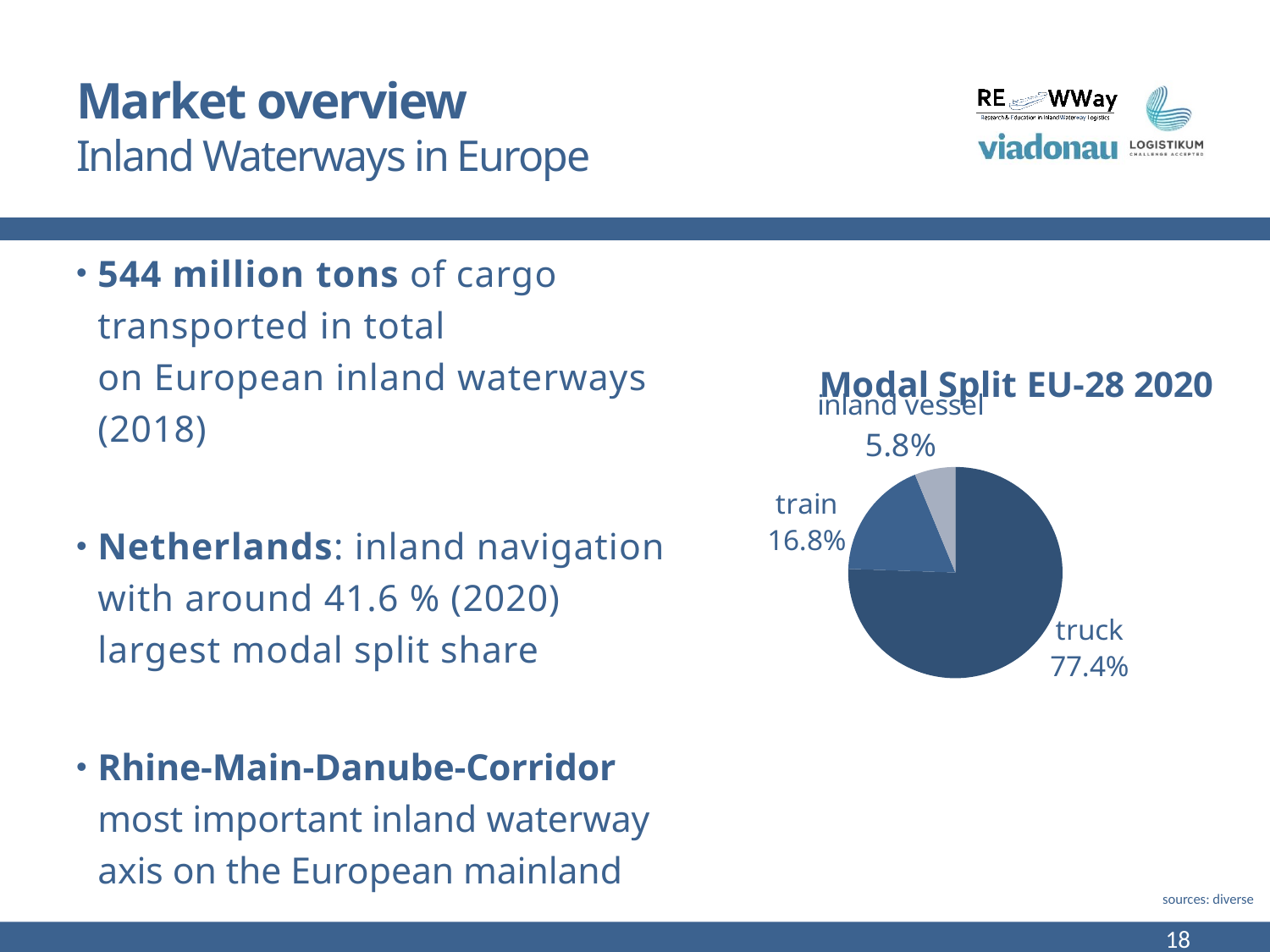
What is the title of the chart on the slide? Modal Split EU-28 2020 What share of the Modal Split EU-28 2020 pie chart is truck? 77.4% What is the difference in percentage points between the truck and train shares in the Modal Split EU-28 2020 chart? 60.6 What is the difference in percentage points between the train and inland vessel shares in the Modal Split EU-28 2020 chart? 11.0 How many slices does the Modal Split EU-28 2020 pie chart have? 3 What kind of chart is shown on the slide? pie chart Which mode has the largest share in the Modal Split EU-28 2020 chart? truck Which mode has the smallest share in the Modal Split EU-28 2020 chart? inland vessel What share of the Modal Split EU-28 2020 pie chart is train? 16.8% What is the combined share of train and inland vessel in the Modal Split EU-28 2020 chart? 22.6% What share of the Modal Split EU-28 2020 pie chart is inland vessel? 5.8% Which has a larger share in the Modal Split EU-28 2020 chart, train or inland vessel? train